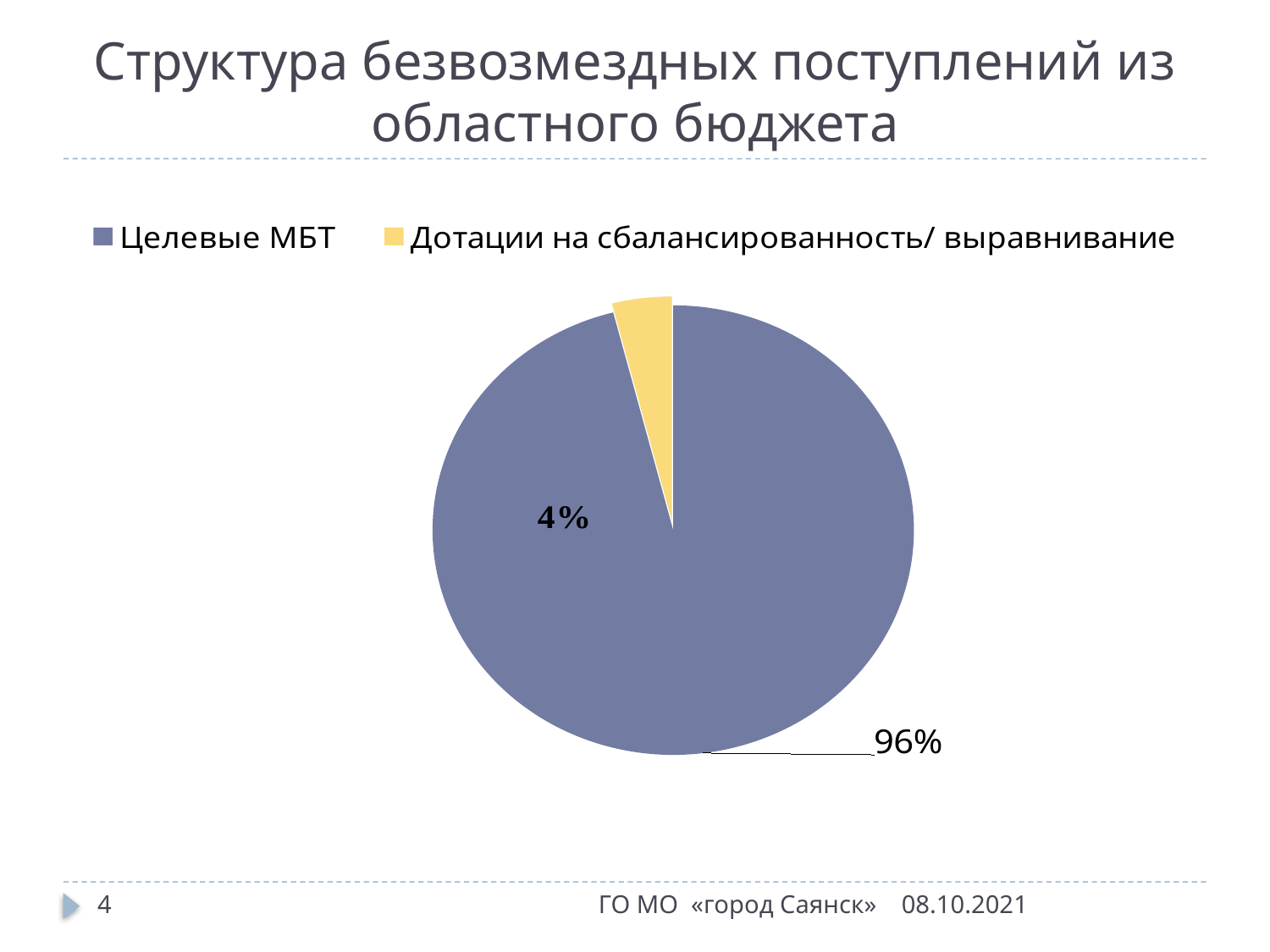
Which slice is the smallest? Дотации на сбалансированность/ выравнивание What is the difference in percentage points between the Целевые МБТ slice and the Дотации на сбалансированность/ выравнивание slice? 92 What is the title of the slide containing the chart? Структура безвозмездных поступлений из областного бюджета How many entries does the legend list? 2 What share of the pie does Дотации на сбалансированность/ выравнивание take? 4% What kind of chart is shown on the slide? pie chart How many slices does the pie chart have? 2 What colour is the Дотации на сбалансированность/ выравнивание slice? yellow Which slice is the largest? Целевые МБТ What share of the pie does Целевые МБТ take? 96% Which is larger: Целевые МБТ or Дотации на сбалансированность/ выравнивание? Целевые МБТ